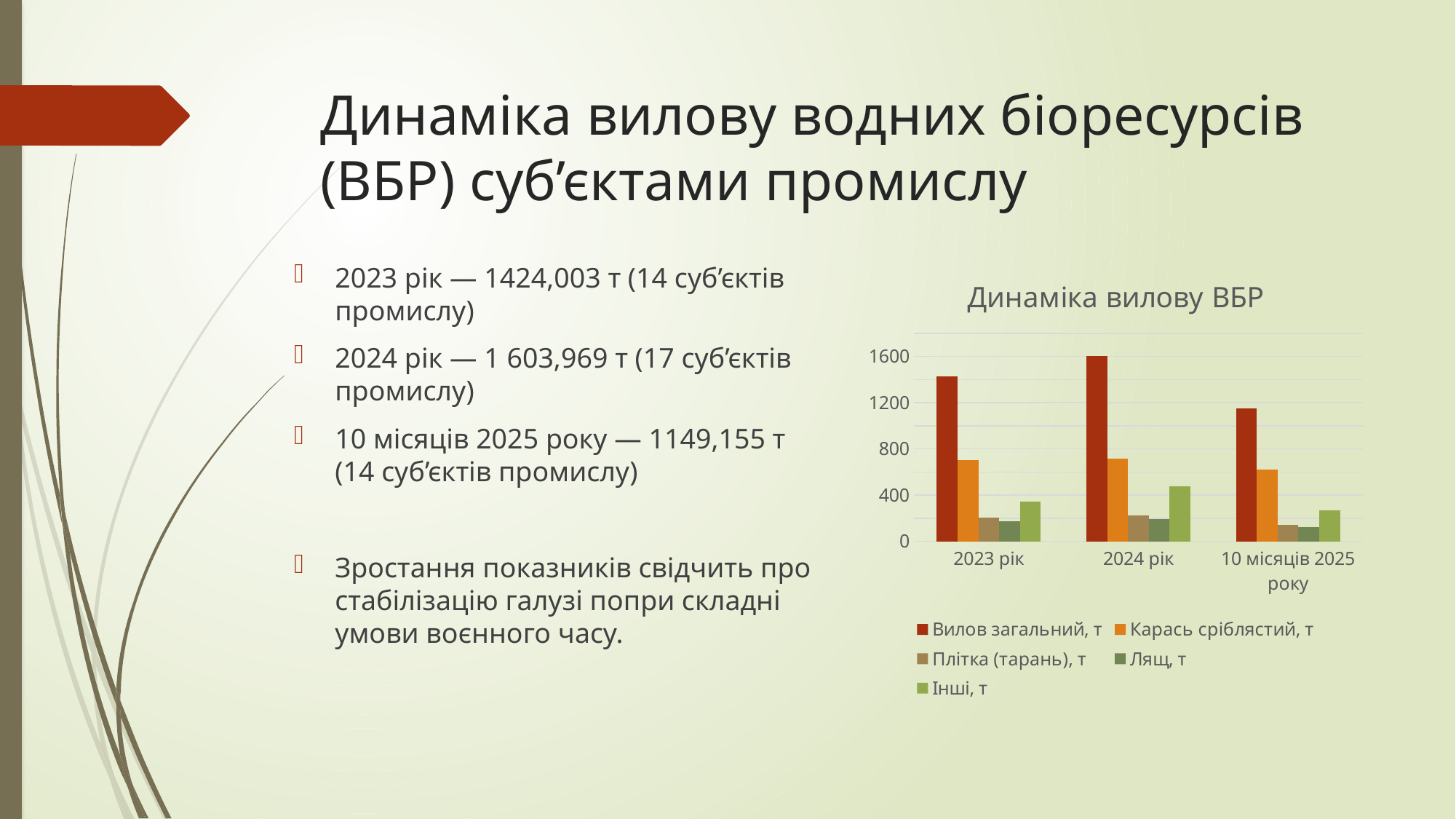
Is the value for 'Вилов загальний, т' in 2023 рік greater or less than 1200? greater How many categories are shown on the x axis of the chart? 3 Is the value for 'Карась сріблястий, т' in 2023 рік greater or less than 800? less What kind of chart is shown on the slide? bar chart Which category has the highest value for the series 'Вилов загальний, т'? 2024 рік How many series does the chart legend list? 5 Does the value for 'Вилов загальний, т' rise or fall from 2024 рік to 10 місяців 2025 року? fall Which category has the lowest value for the series 'Вилов загальний, т'? 10 місяців 2025 року Is the value for 'Лящ, т' in 10 місяців 2025 року greater or less than 400? less What is the title of the chart? Динаміка вилову ВБР In 2023 рік, which is larger: 'Карась сріблястий, т' or 'Інші, т'? Карась сріблястий, т